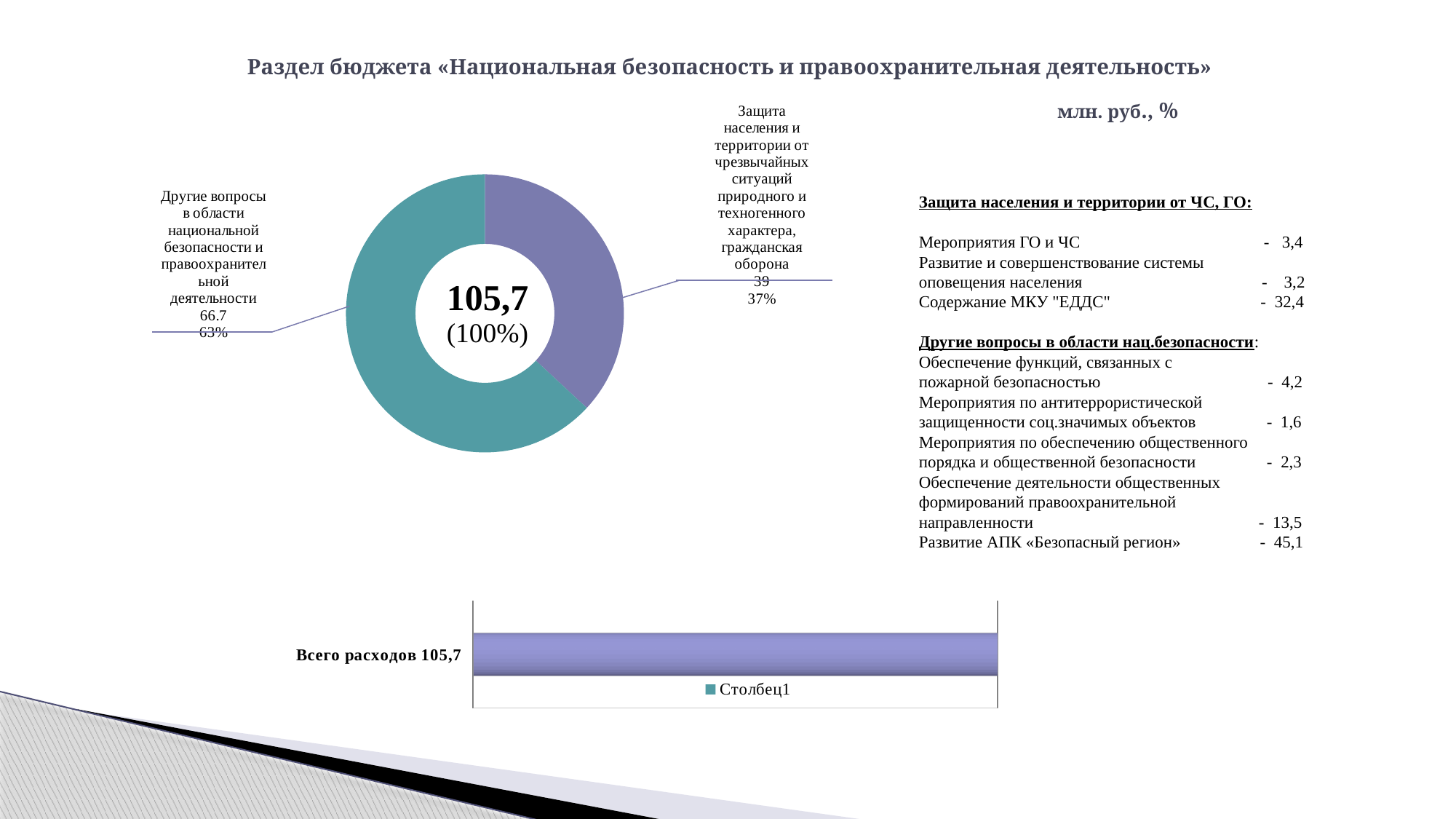
How many slices does the donut chart have? 2 In the donut chart, what is the difference between the two slice values (66.7 and 39)? 27.7 What total value is shown in the centre of the donut chart? 105,7 (100%) In the donut chart, which category has the smallest slice? Защита населения и территории от чрезвычайных ситуаций природного и техногенного характера, гражданская оборона What type of chart is shown at the bottom of the slide? Bar chart In the donut chart, what is the value for «Другие вопросы в области национальной безопасности и правоохранительной деятельности»? 66.7 What type of chart is shown in the upper left of the slide? Donut (pie) chart In the donut chart, what share does «Защита населения и территории от чрезвычайных ситуаций...» take? 37% In the bar chart at the bottom of the slide, what series name does the legend list? Столбец1 In the donut chart, what is the value for «Защита населения и территории от чрезвычайных ситуаций природного и техногенного характера, гражданская оборона»? 39 In the donut chart, what share does «Другие вопросы в области национальной безопасности и правоохранительной деятельности» take? 63% In the donut chart, which category has the largest slice? Другие вопросы в области национальной безопасности и правоохранительной деятельности